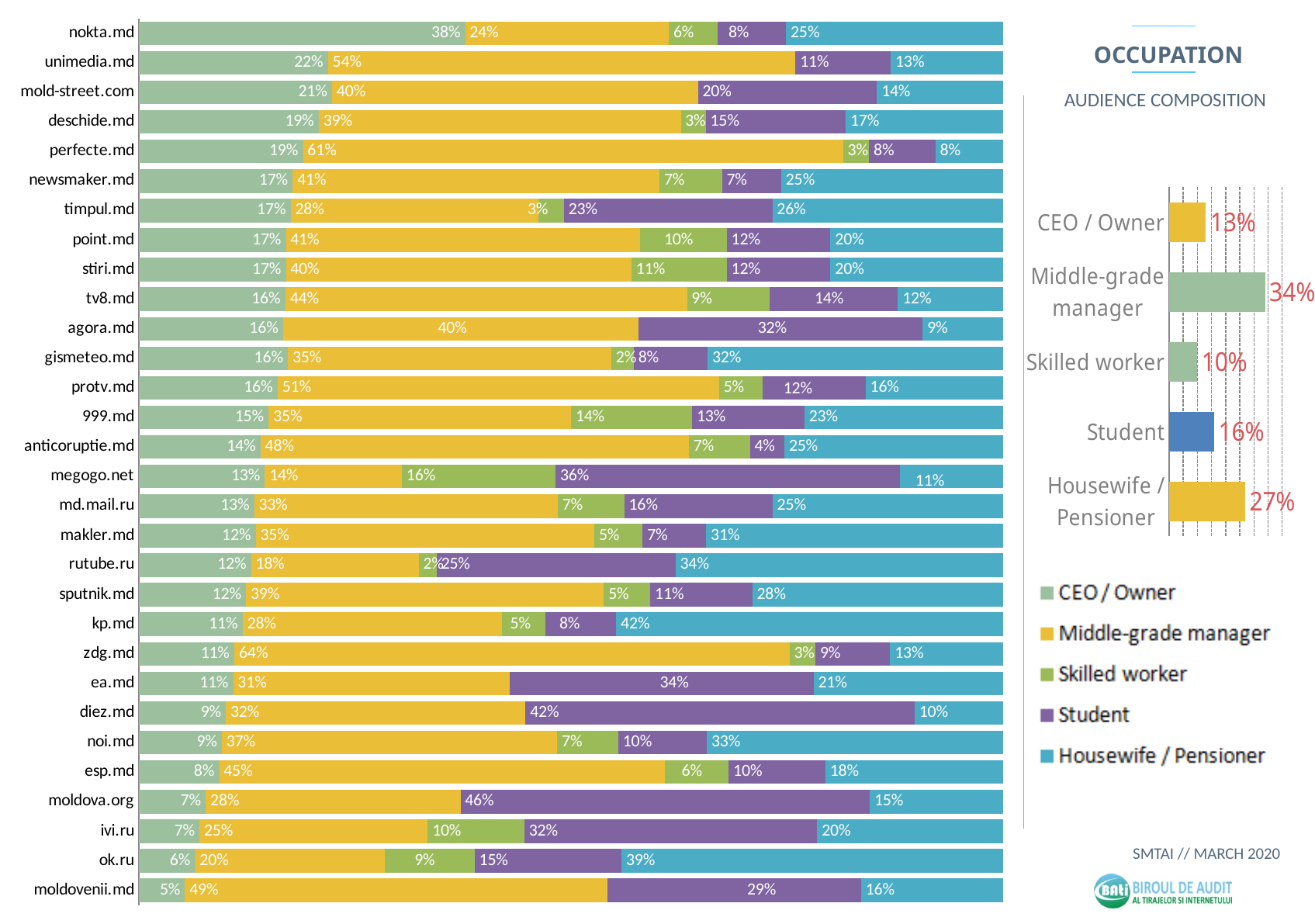
In the stacked bar chart on the left, what is the CEO / Owner share for nokta.md? 38% In the OCCUPATION audience composition chart on the right, which occupation has the lowest value? Skilled worker How many series does the legend list for the stacked bar chart of websites on the left? 5 In the stacked bar chart on the left, what is the Middle-grade manager share for zdg.md? 64% In the stacked bar chart on the left, what is the Housewife / Pensioner share for kp.md? 42% In the stacked bar chart on the left, is the Student share larger for moldova.org or for diez.md? moldova.org How many occupation categories are shown in the OCCUPATION audience composition chart on the right? 5 What kind of chart is the large chart of websites on the left? Stacked bar chart In the OCCUPATION audience composition chart on the right, what is the difference between Housewife / Pensioner and Student? 11% In the OCCUPATION audience composition chart on the right, what is the value for Middle-grade manager? 34% In the stacked bar chart on the left, which website has the highest CEO / Owner share? nokta.md In the OCCUPATION audience composition chart on the right, which occupation has the highest value? Middle-grade manager